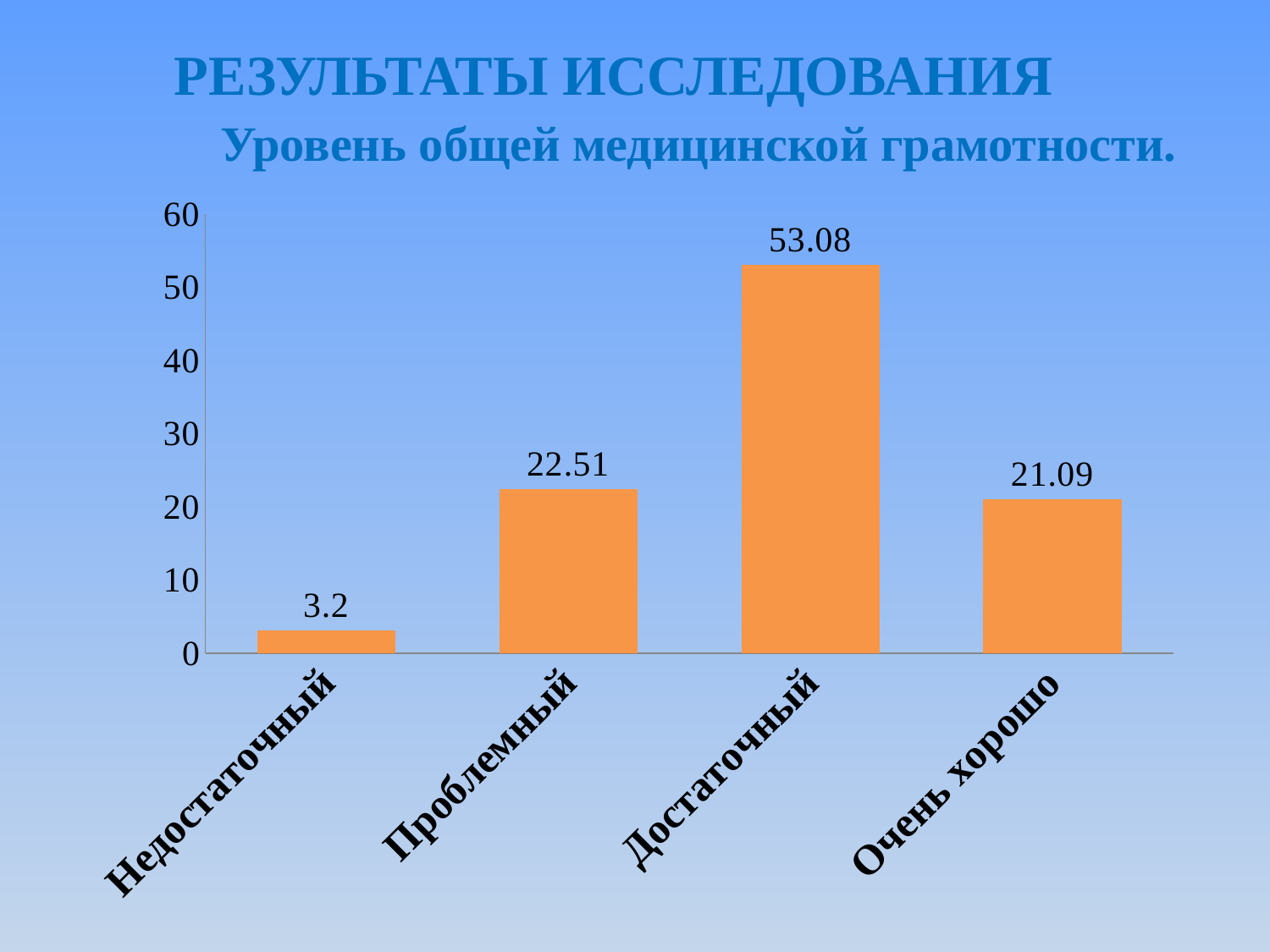
What is the value for Проблемный? 22.51 What kind of chart is shown on the slide? bar chart What is the value for Недостаточный? 3.2 What is the value for Достаточный? 53.08 What is the value for Очень хорошо? 21.09 Which category has the lowest value? Недостаточный Which is larger, the value for Проблемный or the value for Очень хорошо? Проблемный What is the difference between the values for Достаточный and Проблемный? 30.57 What is the subtitle of the chart on the slide? Уровень общей медицинской грамотности. Which category has the highest value? Достаточный Is the value for Достаточный greater or less than 50? greater How many categories are shown on the x axis? 4